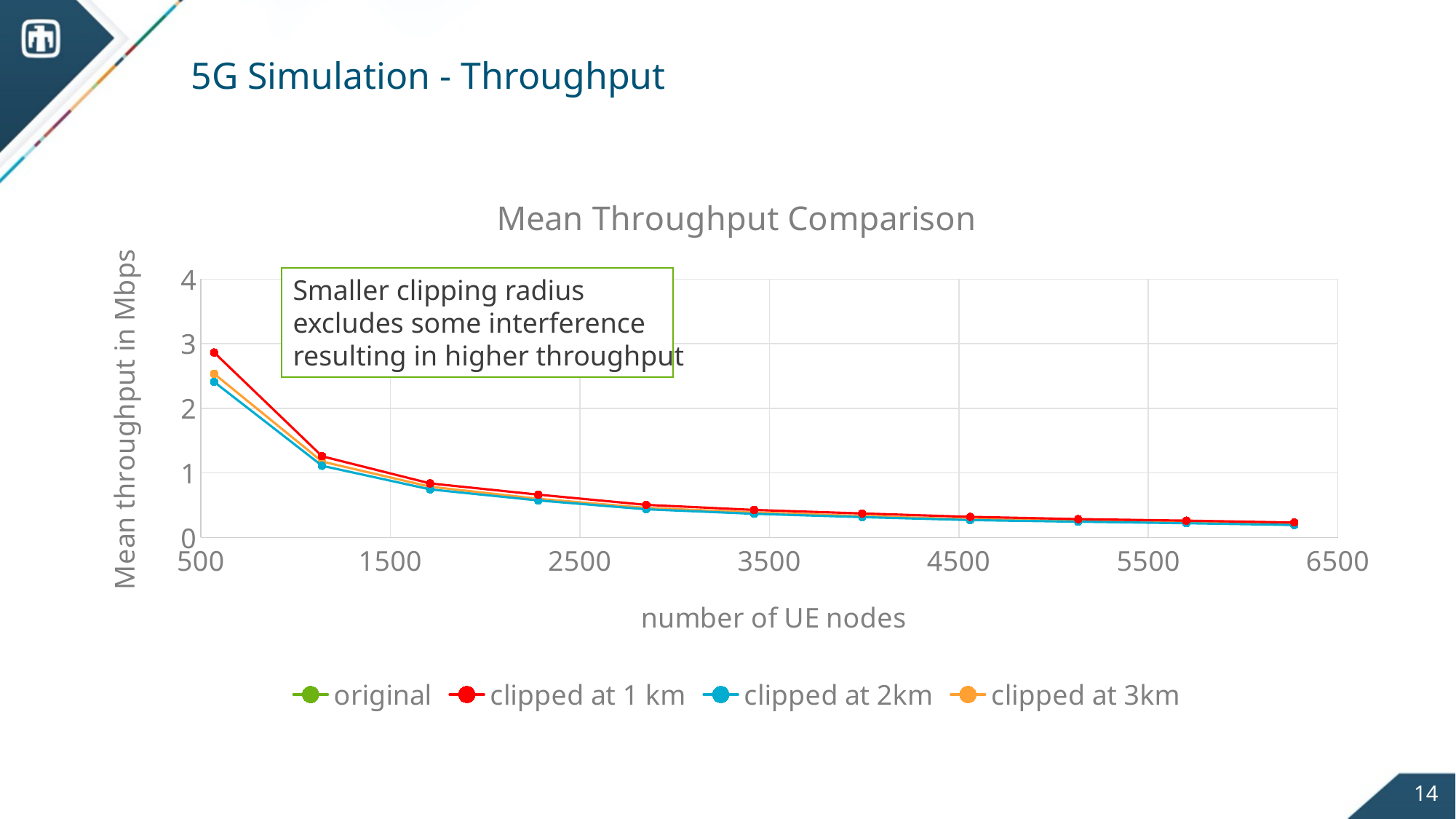
At the leftmost data point, which is larger: the value for clipped at 1 km or the value for clipped at 2km? clipped at 1 km How many series does the legend list? 4 Is the value for clipped at 1 km at the leftmost data point greater or less than 2? greater What is the label of the y axis? Mean throughput in Mbps Is the value for clipped at 2km at the leftmost data point greater or less than 3? less What kind of chart is shown on the slide? line chart Is the value for clipped at 1 km at the rightmost data point greater or less than 1? less What is the title of the chart? Mean Throughput Comparison Do the throughput values rise or fall as the number of UE nodes increases? fall How many data points does each series have? 11 Which series has the highest value at the leftmost data point (around 500 UE nodes)? clipped at 1 km Which series is drawn in red? clipped at 1 km